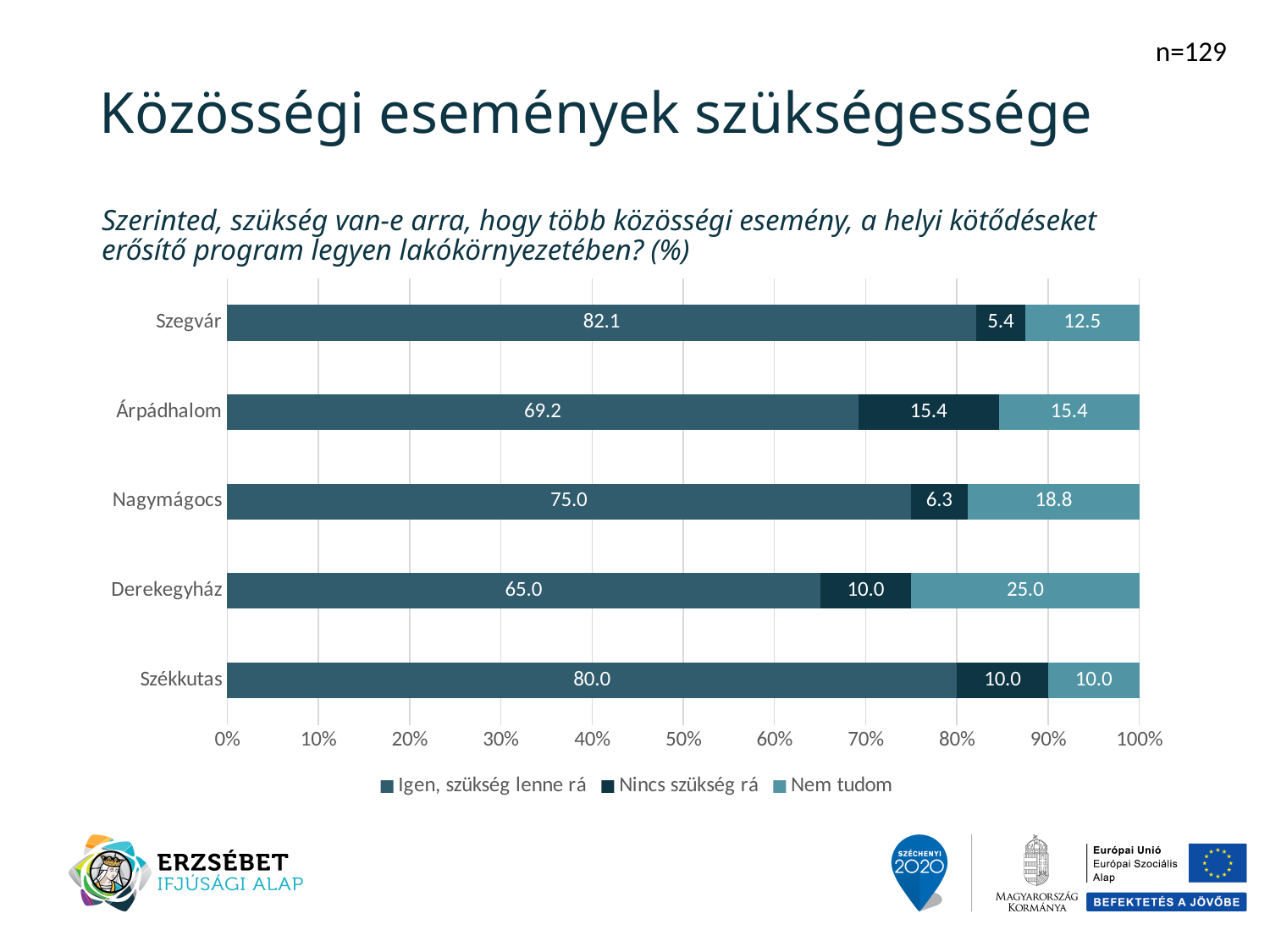
What is the first legend entry of the chart? Igen, szükség lenne rá Which is larger: the "Nem tudom" value for Nagymágocs or for Szegvár? Nagymágocs Which category has the highest value for "Igen, szükség lenne rá"? Szegvár What is the total of the stacked bar for Derekegyház? 100.0 What is the value for "Igen, szükség lenne rá" for Szegvár? 82.1 What kind of chart is shown on the slide? Stacked bar chart What is the value for "Nem tudom" for Derekegyház? 25.0 Which category has the lowest value for "Igen, szükség lenne rá"? Derekegyház What is the difference between the "Igen, szükség lenne rá" values for Székkutas and Nagymágocs? 5.0 How many categories are shown on the chart? 5 How many series does the legend list? 3 What is the value for "Nincs szükség rá" for Árpádhalom? 15.4